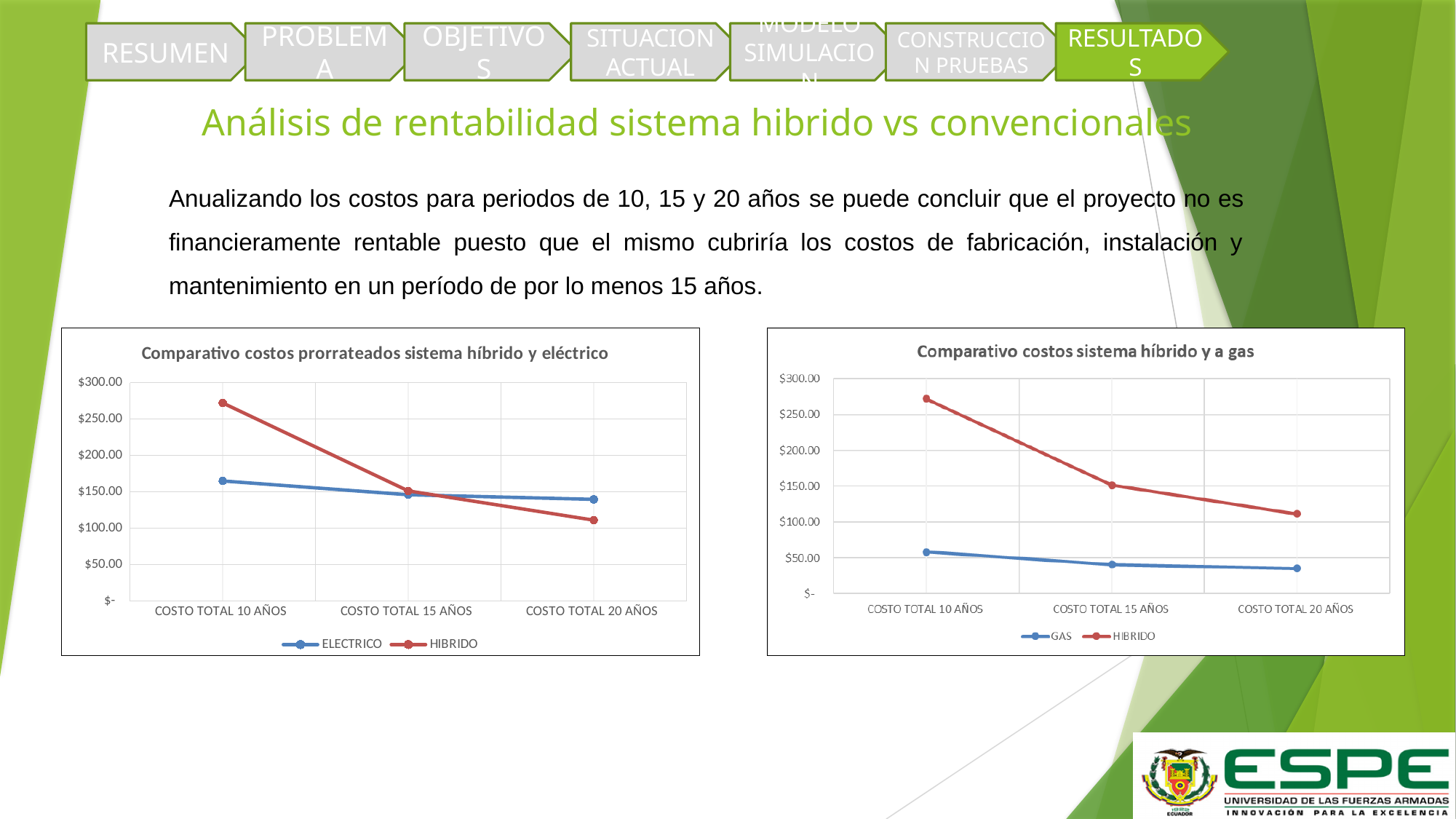
In the right chart, 'Comparativo costos sistema híbrido y a gas', which series has the larger value for COSTO TOTAL 15 AÑOS, GAS or HIBRIDO? HIBRIDO In the left chart, 'Comparativo costos prorrateados sistema híbrido y eléctrico', does the HIBRIDO series rise or fall from COSTO TOTAL 10 AÑOS to COSTO TOTAL 20 AÑOS? Fall In the right chart, 'Comparativo costos sistema híbrido y a gas', is the GAS value for COSTO TOTAL 20 AÑOS greater or less than $50.00? less In the left chart, 'Comparativo costos prorrateados sistema híbrido y eléctrico', is the HIBRIDO value for COSTO TOTAL 10 AÑOS greater or less than $250.00? greater What colour is the HIBRIDO line in the right chart, 'Comparativo costos sistema híbrido y a gas'? Red In the left chart, 'Comparativo costos prorrateados sistema híbrido y eléctrico', which series has the larger value for COSTO TOTAL 10 AÑOS, ELECTRICO or HIBRIDO? HIBRIDO In the left chart, 'Comparativo costos prorrateados sistema híbrido y eléctrico', is the ELECTRICO value for COSTO TOTAL 10 AÑOS greater or less than $200.00? less How many categories are shown on the x axis of the left chart, 'Comparativo costos prorrateados sistema híbrido y eléctrico'? 3 What type of chart is the left chart, 'Comparativo costos prorrateados sistema híbrido y eléctrico'? Line chart In the left chart, 'Comparativo costos prorrateados sistema híbrido y eléctrico', which series has the larger value for COSTO TOTAL 20 AÑOS, ELECTRICO or HIBRIDO? ELECTRICO How many series does the legend of the right chart, 'Comparativo costos sistema híbrido y a gas', list? 2